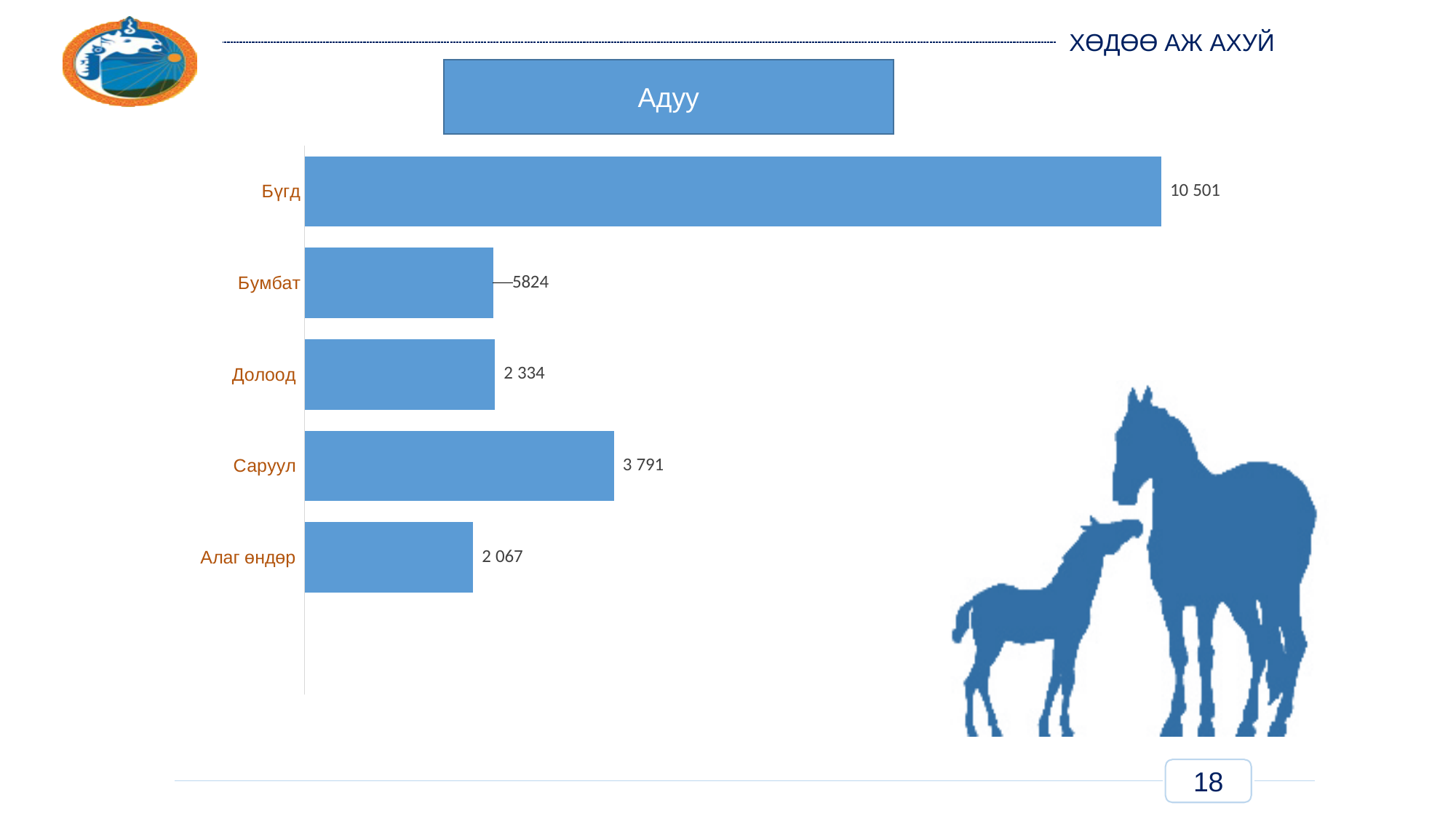
What is the value for Саруул? 3 791 What kind of chart is shown on the slide? Bar chart What is the difference between the values for Бүгд and Саруул? 6 710 How many categories are shown in the chart? 5 What is the value for Долоод? 2 334 Which is larger, the value for Саруул or the value for Долоод? Саруул What is the title of the chart? Адуу Which category has the lowest value? Алаг өндөр What is the value for Бүгд? 10 501 What is the value for Алаг өндөр? 2 067 Which category has the highest value? Бүгд What is the difference between the values for Саруул and Долоод? 1 457